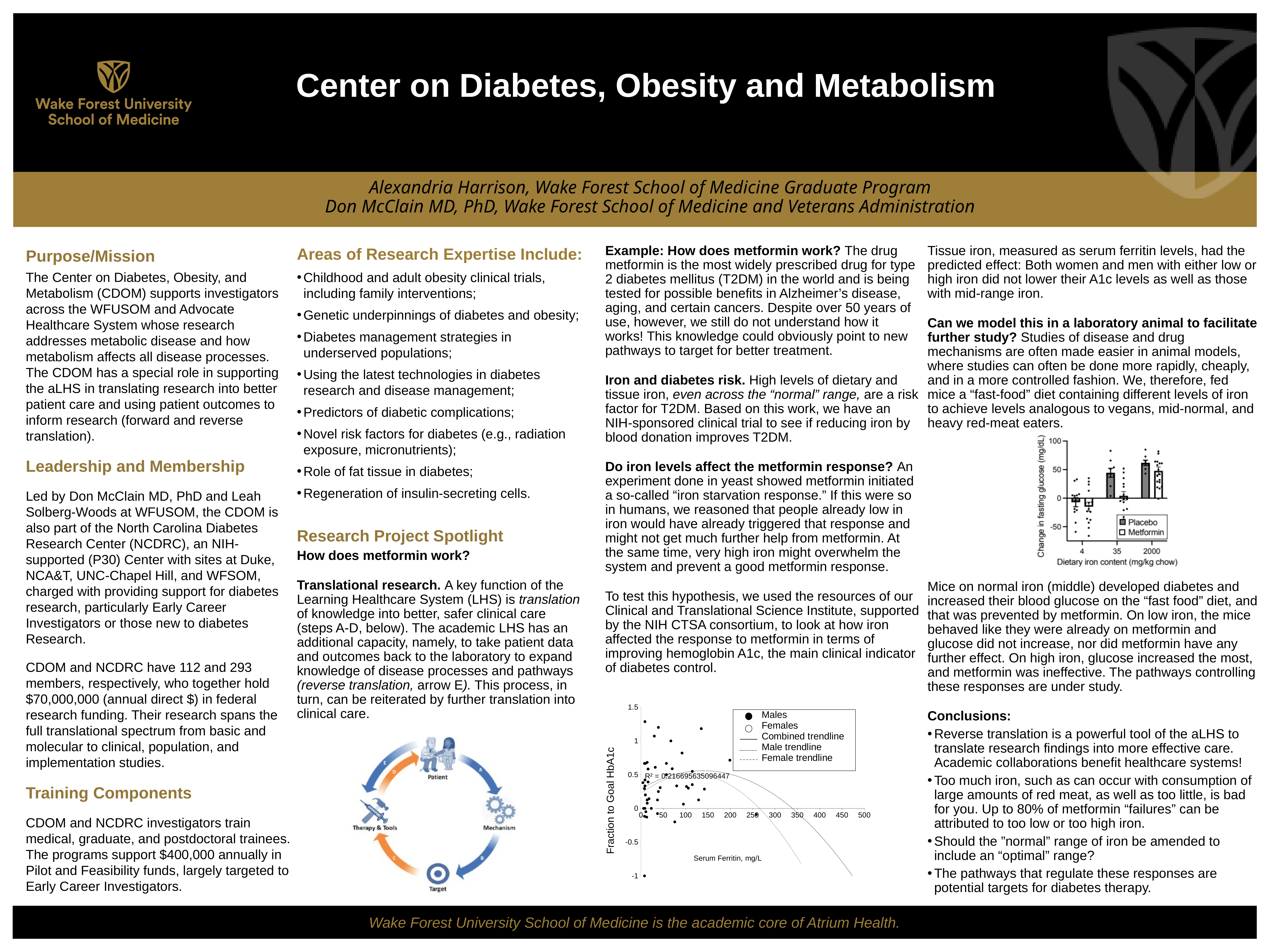
In the scatter chart of Fraction to Goal HbA1c, how many entries does the legend list? 5 What kind of chart is the chart with the y axis 'Fraction to Goal HbA1c'? scatter chart In the bar chart of change in fasting glucose, at which dietary iron content is the Placebo bar highest? 2000 In the bar chart of change in fasting glucose, is the Placebo value at 35 mg/kg chow greater or less than 0? greater In the bar chart of change in fasting glucose, which two series are named in the legend? Placebo and Metformin In the bar chart of change in fasting glucose, how many dietary iron content categories are shown on the x axis? 3 In the bar chart of change in fasting glucose, is the Metformin value at 35 mg/kg chow greater or less than 50? less In the bar chart of change in fasting glucose, how many series does the legend list? 2 In the bar chart of change in fasting glucose, at 35 mg/kg chow, which is larger: Placebo or Metformin? Placebo What kind of chart is the chart with the x axis 'Dietary iron content (mg/kg chow)'? bar chart In the scatter chart of Fraction to Goal HbA1c, what R² value is printed on the chart? R² = 0.216695635096447 In the bar chart of change in fasting glucose, is the Placebo value at 2000 mg/kg chow greater or less than 50? greater